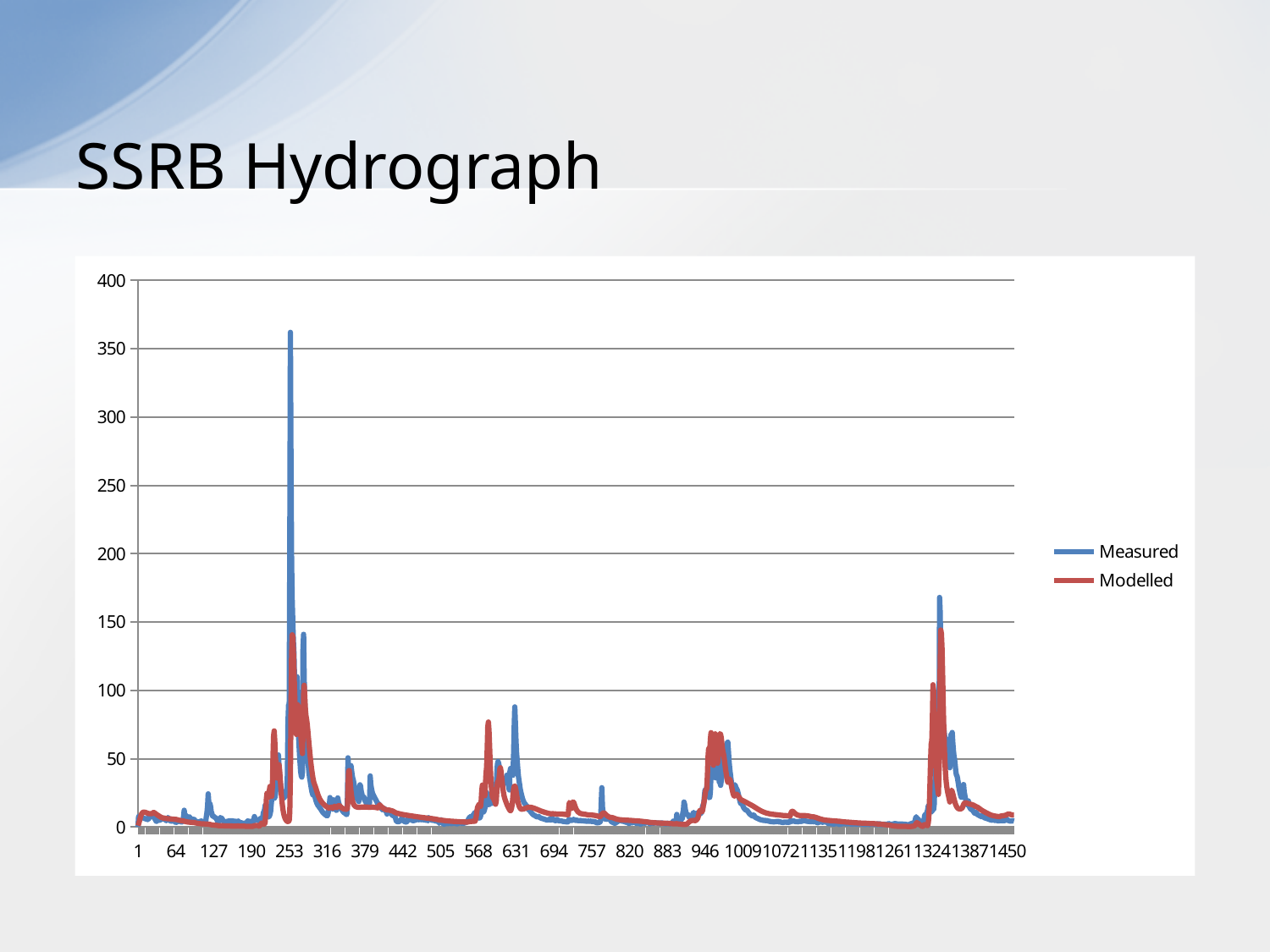
Is the highest peak of the Measured series greater or less than 350? greater What kind of chart is shown on the slide? Line chart Is the Modelled peak near x = 946 greater or less than 50? greater What is the maximum value shown on the vertical axis? 400 What is the title of the chart? SSRB Hydrograph What are the two series named in the legend? Measured and Modelled How many series does the legend list? 2 Is the Measured peak near x = 631 greater or less than 100? less Around x = 253, which series reaches the higher peak, Measured or Modelled? Measured